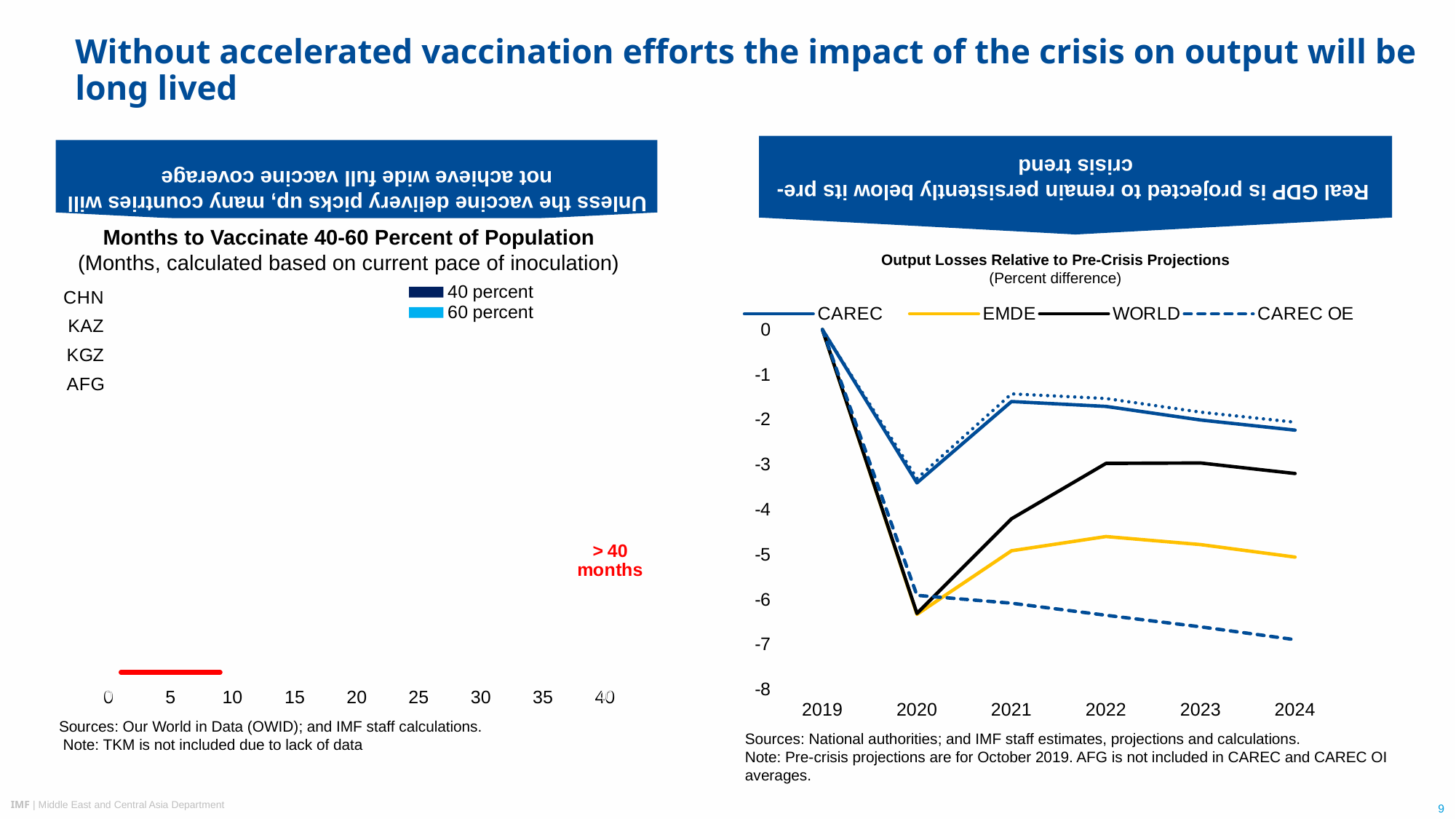
In the 'Output Losses Relative to Pre-Crisis Projections' chart, in which year does the WORLD series reach its lowest value? 2020 How many years are shown on the x axis of the 'Output Losses Relative to Pre-Crisis Projections' chart? 6 What kind of chart is the 'Output Losses Relative to Pre-Crisis Projections' chart? line chart In the 'Output Losses Relative to Pre-Crisis Projections' chart, which series has the lowest value in 2024? CAREC OE In the 'Output Losses Relative to Pre-Crisis Projections' chart, is the CAREC OE value in 2024 greater or less than -6? less In the 'Output Losses Relative to Pre-Crisis Projections' chart, does the CAREC OE series rise or fall from 2020 to 2024? fall In the 'Output Losses Relative to Pre-Crisis Projections' chart, is the EMDE value in 2022 greater or less than -5? greater How many series does the legend of the 'Output Losses Relative to Pre-Crisis Projections' chart list? 4 In the 'Output Losses Relative to Pre-Crisis Projections' chart, is the CAREC value in 2020 greater or less than -3? less How many series does the legend of the 'Months to Vaccinate 40-60 Percent of Population' chart list? 2 In the 'Output Losses Relative to Pre-Crisis Projections' chart, which is larger in 2022, the CAREC value or the EMDE value? CAREC